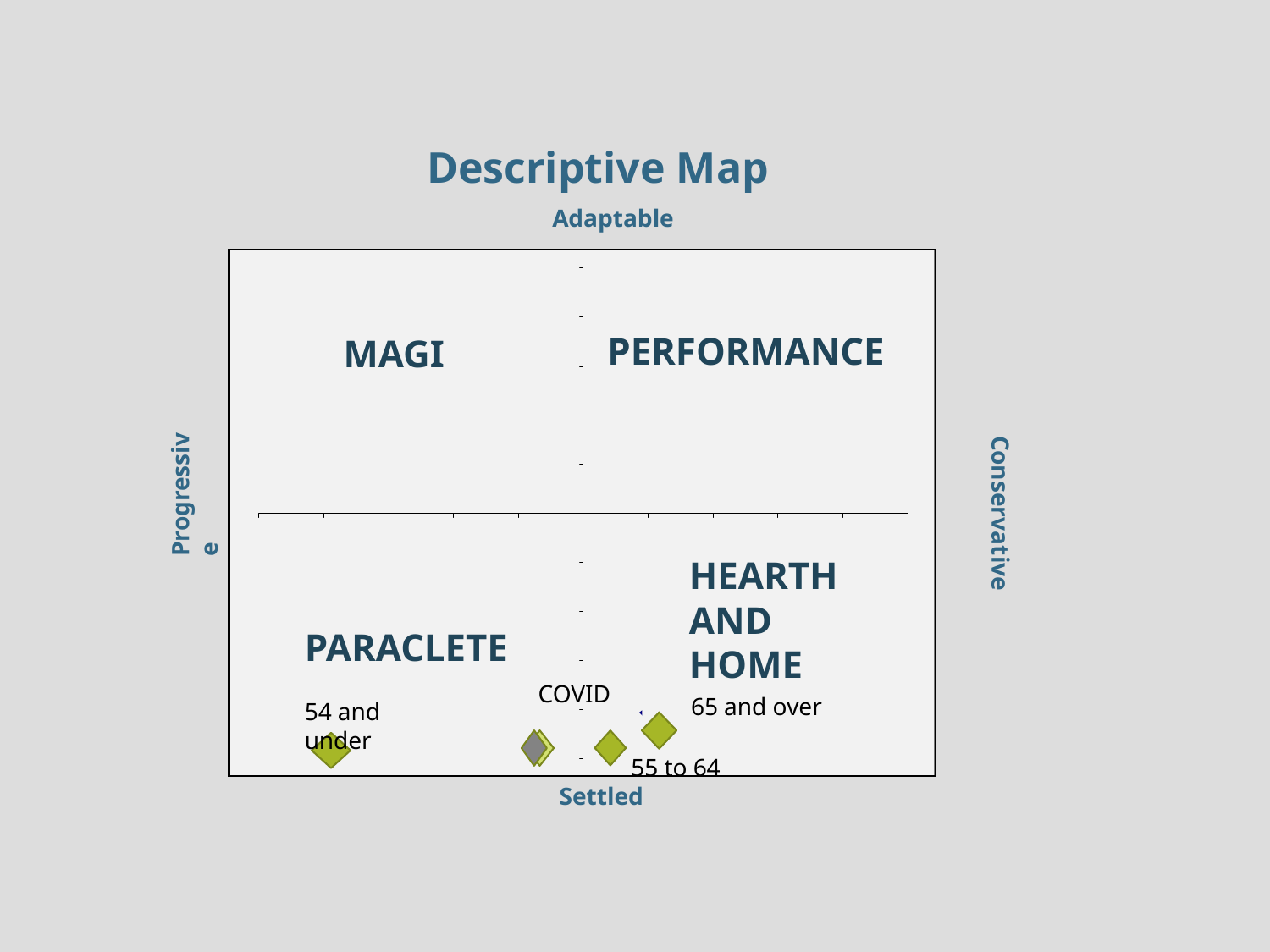
Which is plotted further to the right, the point for 65 and over or the point for 54 and under? 65 and over What label appears at the top of the chart's vertical axis? Adaptable Which is plotted further to the right, the point for 55 to 64 or the point for COVID? 55 to 64 How many labelled data points are plotted on the chart? 4 Are the plotted points in the upper half or the lower half of the chart? Lower half What kind of chart is shown on the slide? Scatter chart What is the title of the chart? Descriptive Map Which labelled data point is plotted furthest to the right on the chart? 65 and over In which named quadrant does the point for 54 and under fall? PARACLETE Which labelled data point is plotted furthest to the left on the chart? 54 and under Which quadrant label is in the top-left of the chart? MAGI In which named quadrant does the point for 65 and over fall? HEARTH AND HOME